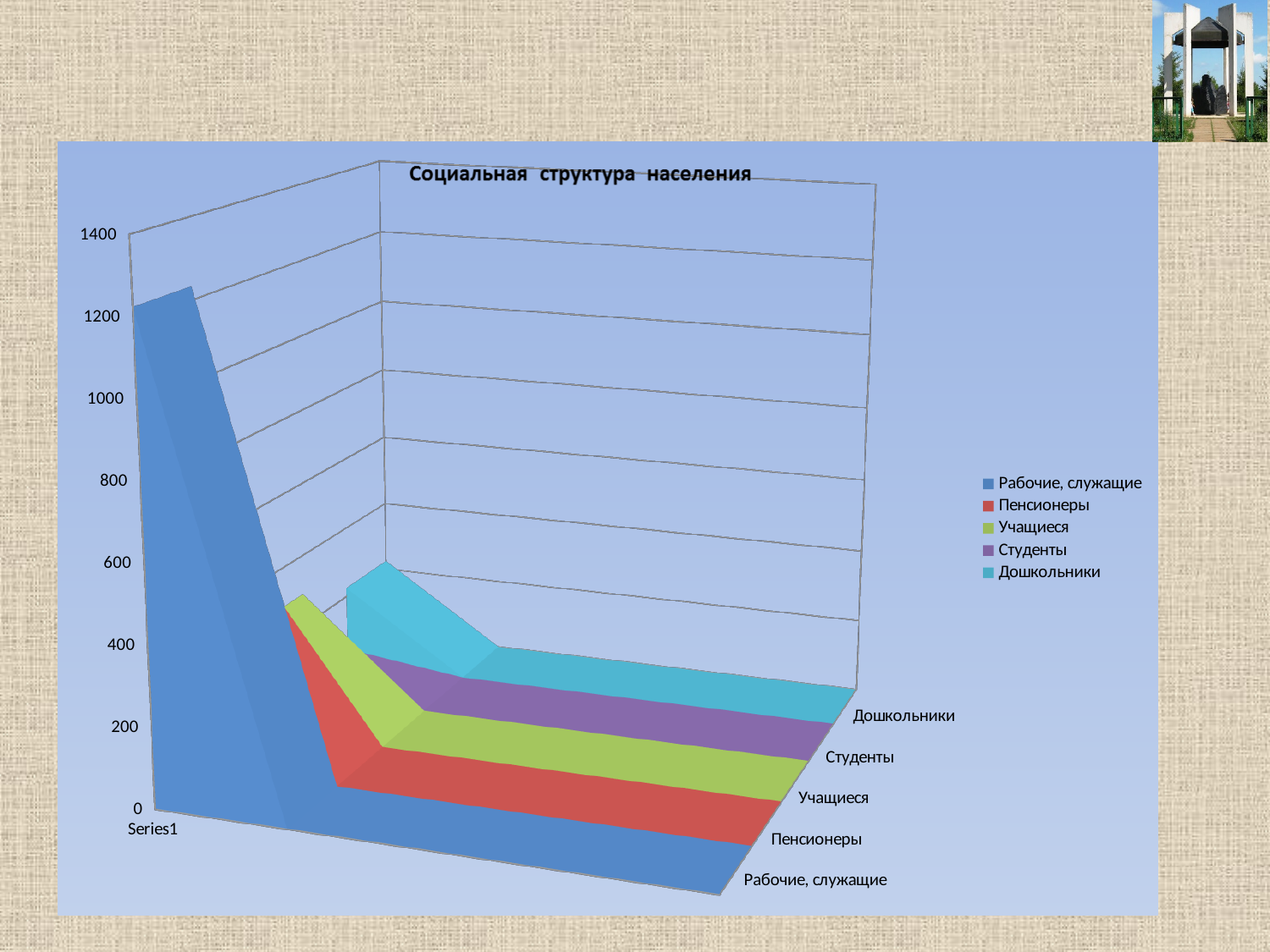
Which is larger, the value for Рабочие, служащие or the value for Дошкольники? Рабочие, служащие Which is larger, the value for Рабочие, служащие or the value for Пенсионеры? Рабочие, служащие What kind of chart is shown on the slide? Area chart Which series has the highest value in the chart? Рабочие, служащие How many series does the legend list? 5 Is the value for Дошкольники greater or less than 800? less Is the value for Пенсионеры greater or less than 800? less What is the label of the single category on the horizontal axis? Series1 Is the value for Рабочие, служащие greater or less than 1000? greater What is the title of the chart? Социальная структура населения What is the highest value shown on the vertical axis? 1400